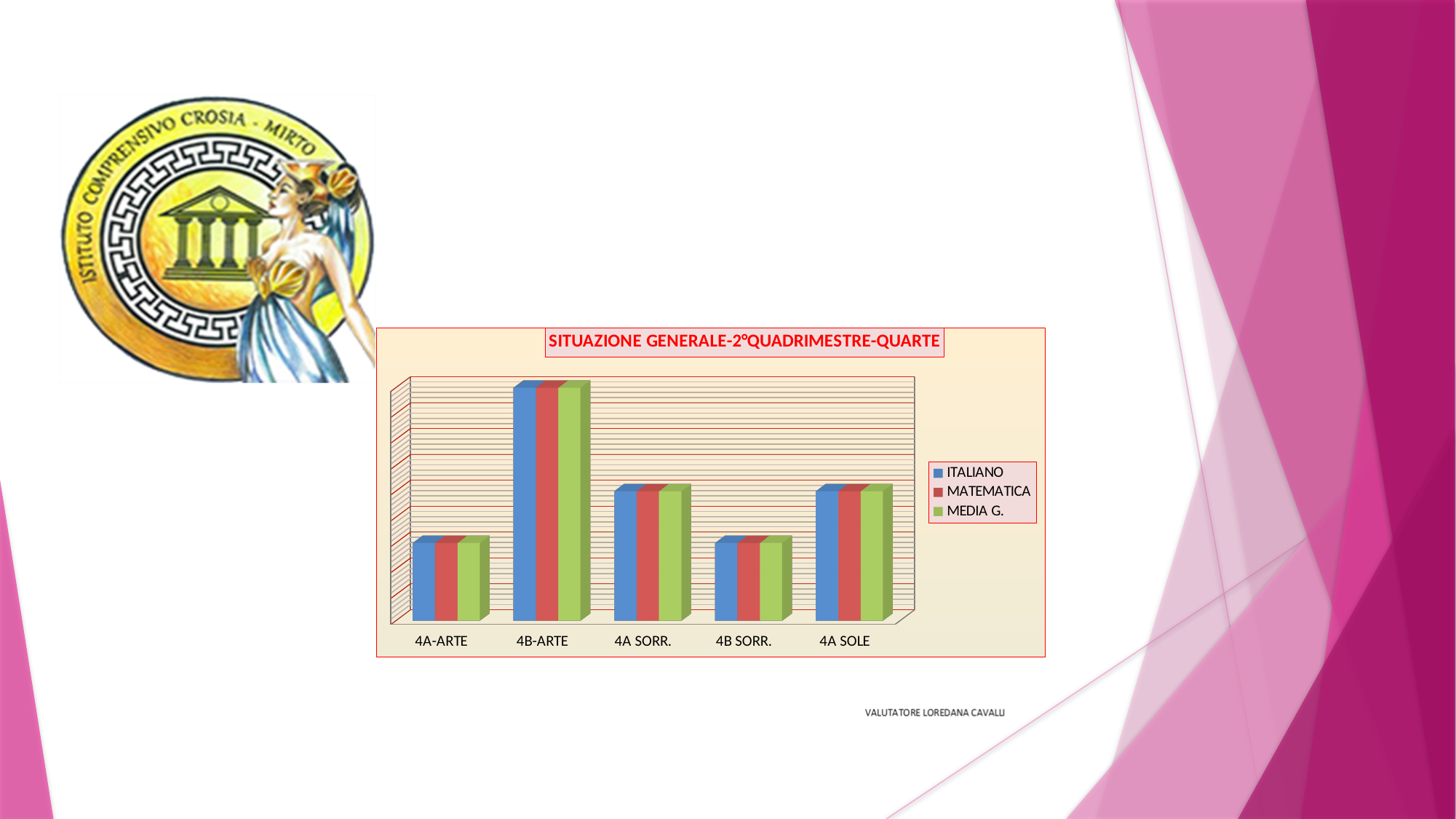
How many series does the legend list? 3 Which category has the highest bars? 4B-ARTE What kind of chart is shown on the slide? bar chart What is the title of the chart? SITUAZIONE GENERALE-2°QUADRIMESTRE-QUARTE Which series are listed in the legend? ITALIANO, MATEMATICA, MEDIA G. Which is larger, the ITALIANO value for 4B-ARTE or the ITALIANO value for 4A SORR.? 4B-ARTE Which is larger, the MATEMATICA value for 4A SORR. or the MATEMATICA value for 4B SORR.? 4A SORR. Which is larger, the MEDIA G. value for 4A SOLE or the MEDIA G. value for 4A-ARTE? 4A SOLE How many categories are shown on the x axis? 5